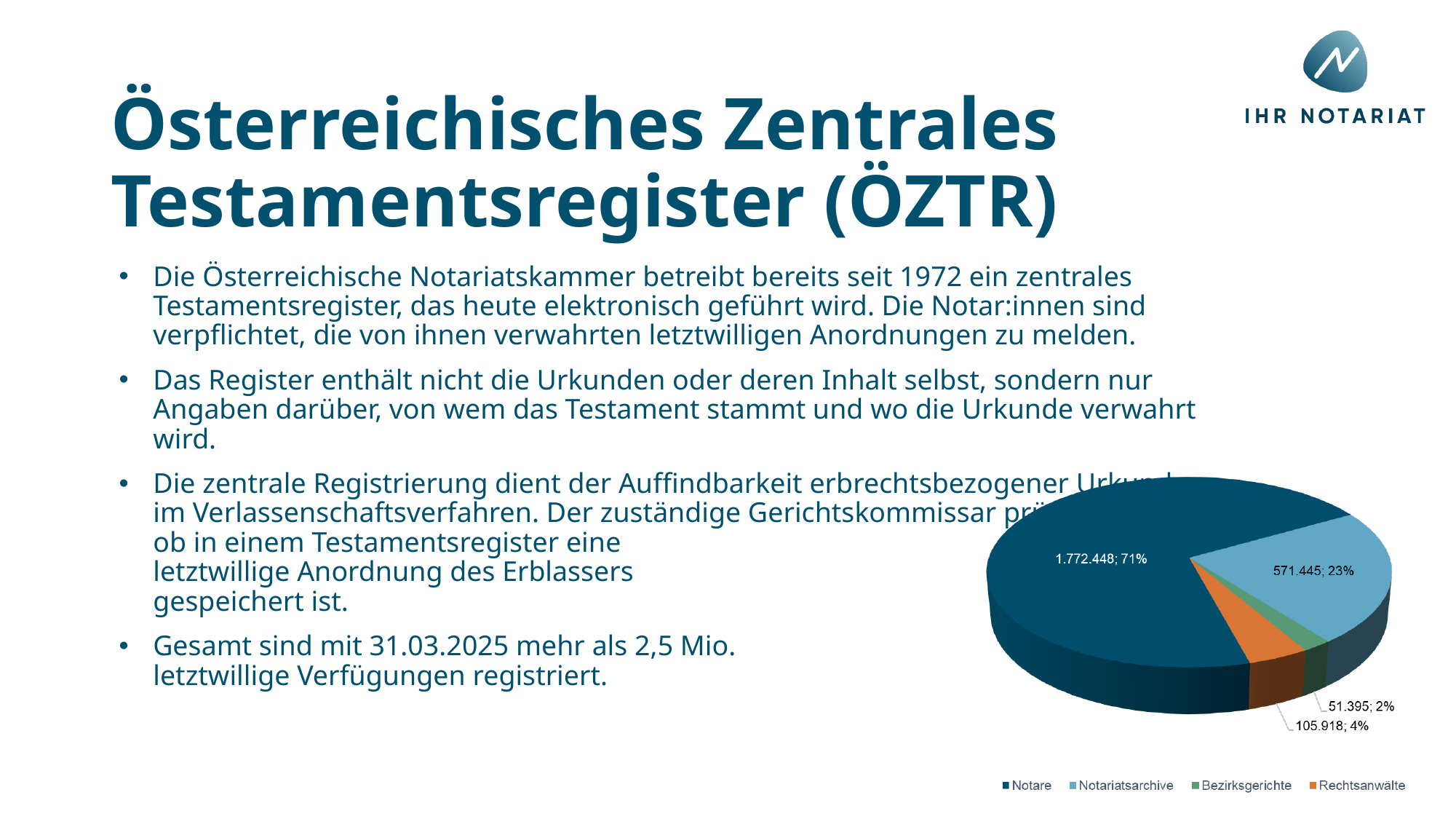
What share of the pie does Notariatsarchive account for? 23% What value is shown for Bezirksgerichte in the pie chart? 51.395 Which is larger in the pie chart, Rechtsanwälte or Bezirksgerichte? Rechtsanwälte What value is shown for Notare in the pie chart? 1.772.448 What kind of chart is shown on the slide? pie chart How many series does the legend of the pie chart list? 4 Which category has the smallest slice in the pie chart? Bezirksgerichte What share of the pie does Notare account for? 71% What value is shown for Rechtsanwälte in the pie chart? 105.918 What value is shown for Notariatsarchive in the pie chart? 571.445 What is the difference between the values for Notare and Notariatsarchive in the pie chart? 1.201.003 Which category has the largest slice in the pie chart? Notare